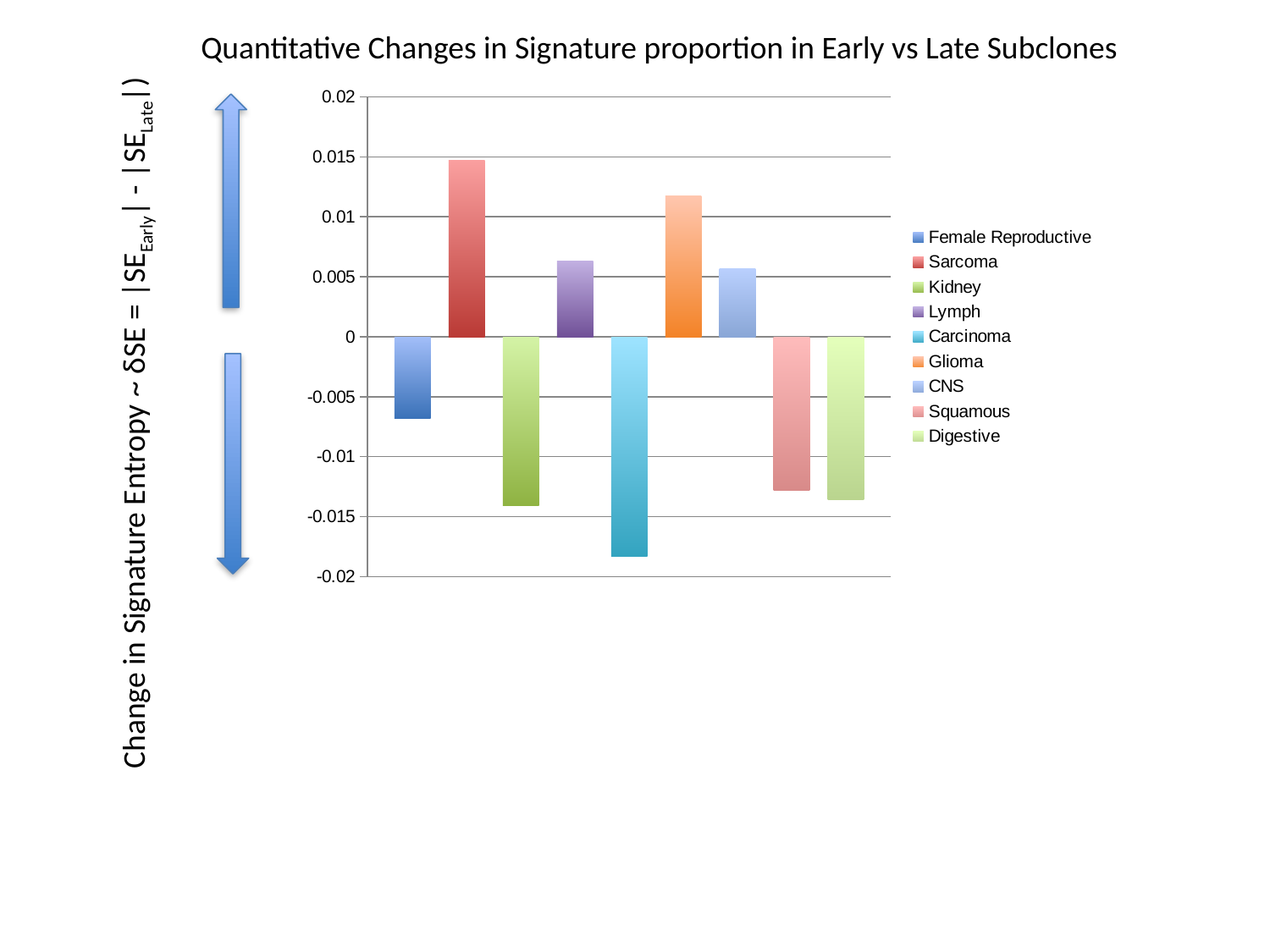
Which is larger, the value for Sarcoma or the value for Glioma? Sarcoma What kind of chart is shown on the slide? bar chart How many bars are plotted in the chart? 9 Which category has the highest value? Sarcoma Which is larger, the value for Female Reproductive or the value for Squamous? Female Reproductive Is the value for Kidney greater or less than -0.01? less Is the value for Female Reproductive greater or less than -0.005? less What is the title of the chart? Quantitative Changes in Signature proportion in Early vs Late Subclones How many series does the legend list? 9 Is the value for Carcinoma greater or less than -0.015? less Which category has the lowest value? Carcinoma